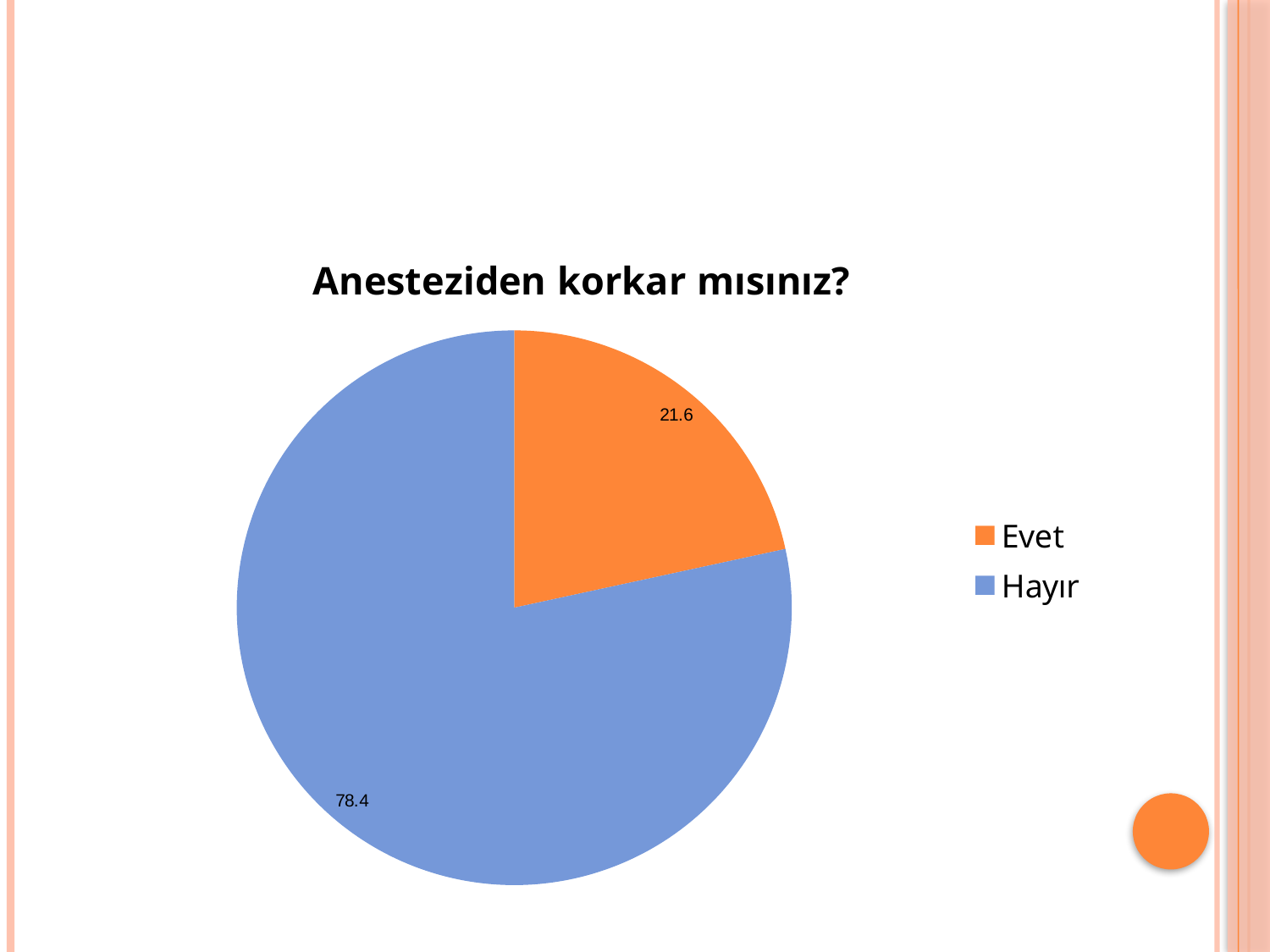
How many entries does the legend list? 2 Which category has the smallest slice? Evet Which category has the largest slice? Hayır What is the difference between the values for Hayır and Evet? 56.8 What is the title of the chart? Anesteziden korkar mısınız? What is the value shown for Hayır? 78.4 Which colour represents Evet in the chart? orange What is the total of the two slice values? 100 How many slices does the pie chart have? 2 What is the value shown for Evet? 21.6 What kind of chart is shown on the slide? pie chart Which is larger, the value for Evet or the value for Hayır? Hayır